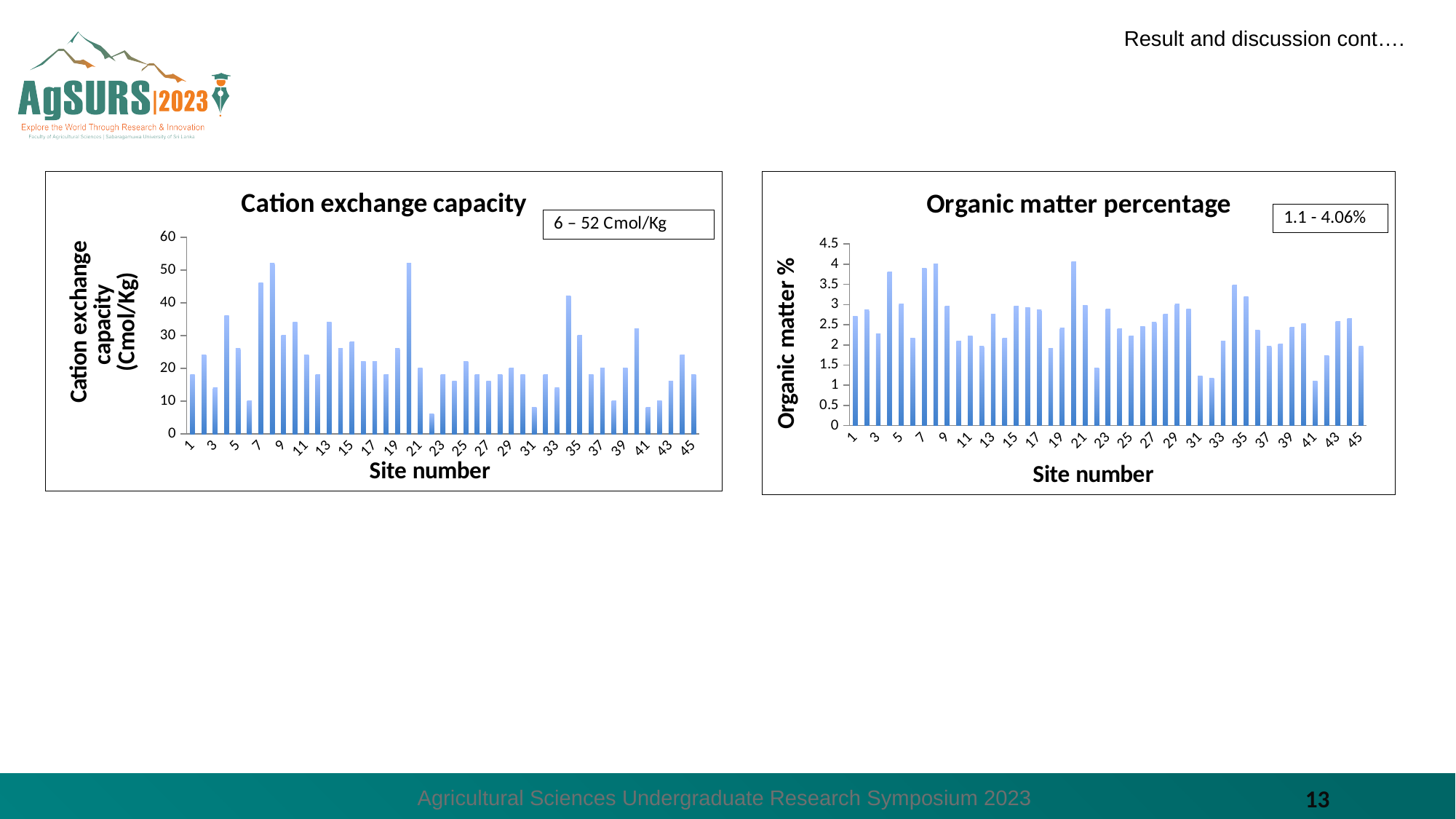
What range is shown in the text box on the 'Cation exchange capacity' chart? 6 – 52 Cmol/Kg In the 'Organic matter percentage' chart, which site has the larger value, site 20 or site 22? Site 20 In the 'Cation exchange capacity' chart, which site has the larger value, site 6 or site 8? Site 8 What range is shown in the text box on the 'Organic matter percentage' chart? 1.1 - 4.06% How many sites are plotted in the 'Cation exchange capacity' chart? 45 How many sites are plotted in the 'Organic matter percentage' chart? 45 What kind of chart is the 'Cation exchange capacity' chart? Bar chart In the 'Cation exchange capacity' chart, is the value for site 22 greater or less than 10? less In the 'Organic matter percentage' chart, is the value for site 4 greater or less than 3.5? greater In the 'Cation exchange capacity' chart, is the value for site 4 greater or less than 30? greater